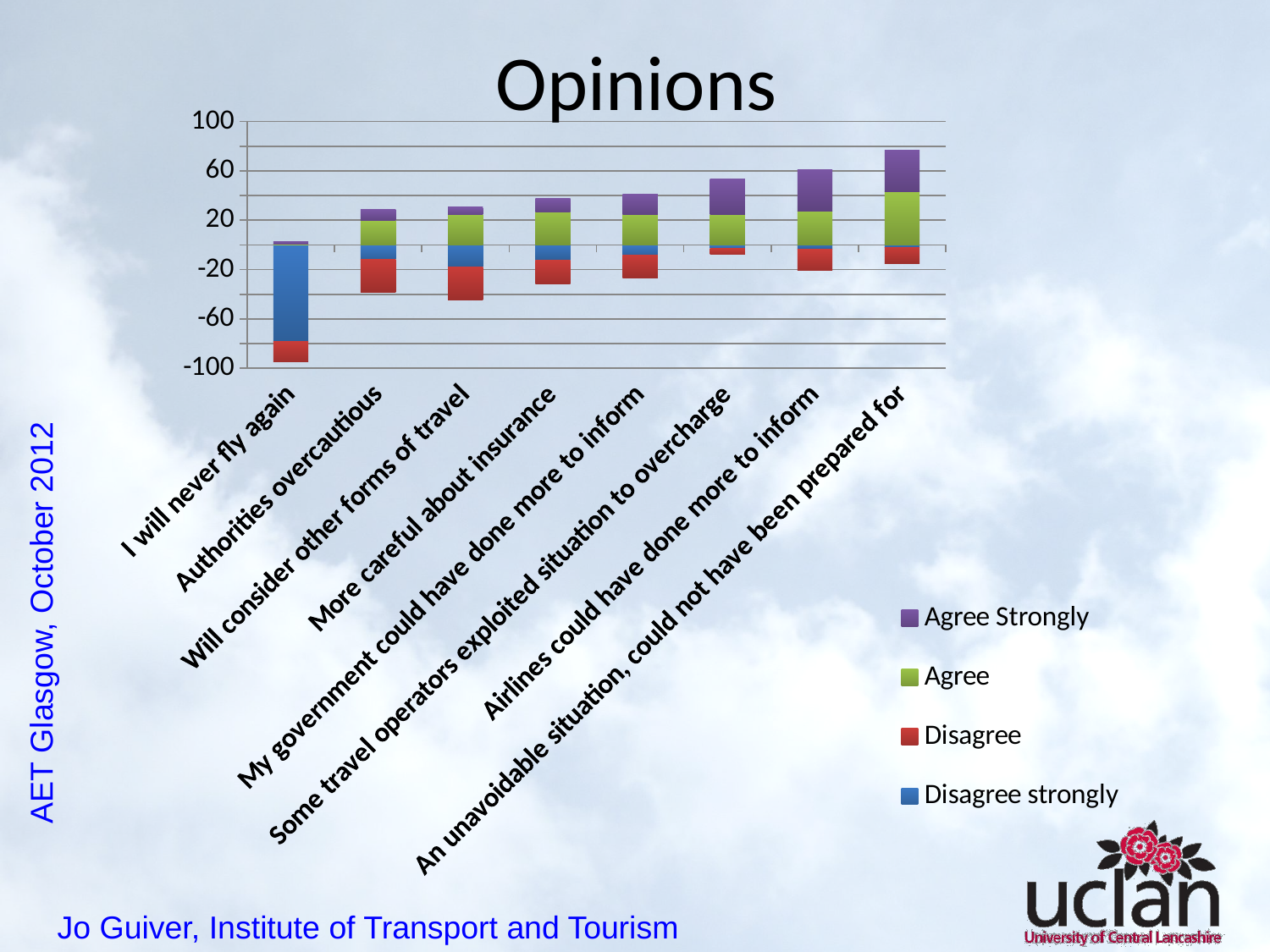
Which statement has the smallest total disagree (negative) portion of its bar? Some travel operators exploited situation to overcharge How many categories (statements) are shown along the x axis of the chart? 8 What type of chart is shown on the slide? bar chart What is the title of the chart? Opinions Moving from left to right along the x axis, do the positive (agree) portions of the bars generally rise or fall? rise Which colour represents 'Agree Strongly' in the chart's legend? purple Is the 'Disagree strongly' value for 'I will never fly again' greater or less than -60? less Which statement has the larger 'Agree Strongly' segment: 'I will never fly again' or 'An unavoidable situation, could not have been prepared for'? An unavoidable situation, could not have been prepared for How many series does the chart's legend list? 4 Which statement has the largest 'Disagree strongly' segment? I will never fly again Is the top of the agree (positive) stack for 'An unavoidable situation, could not have been prepared for' greater or less than 60? greater